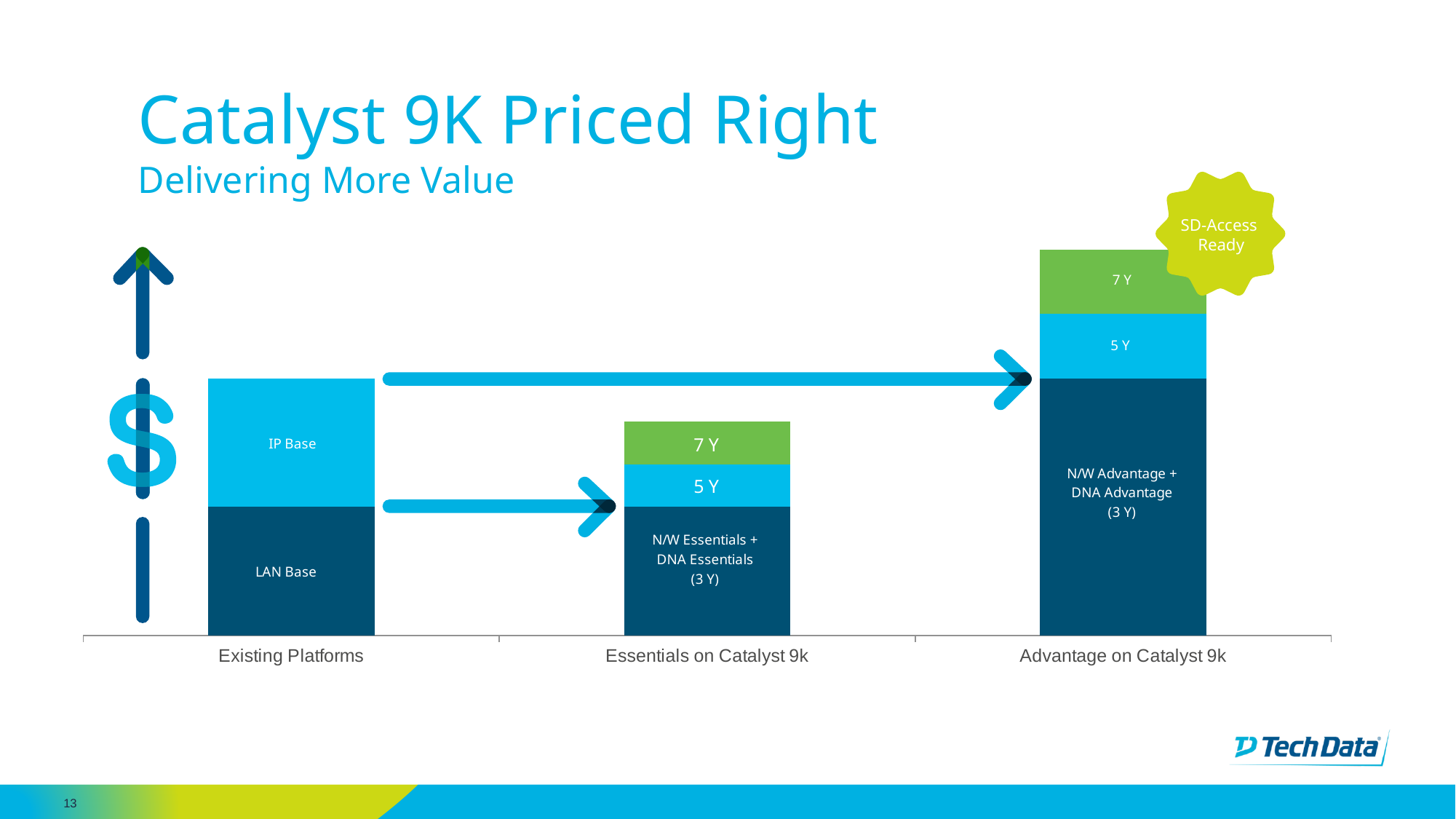
Which bar is taller, Existing Platforms or Essentials on Catalyst 9k? Existing Platforms What is the label on the bottom segment of the Essentials on Catalyst 9k bar? N/W Essentials + DNA Essentials (3 Y) How many segments make up the Advantage on Catalyst 9k bar? 3 What are the two segments labelled in the Existing Platforms bar? IP Base and LAN Base How many categories are shown along the x axis of the chart? 3 Which category has the tallest bar in the chart? Advantage on Catalyst 9k Which bar is taller, Advantage on Catalyst 9k or Existing Platforms? Advantage on Catalyst 9k Which category has the shortest bar in the chart? Essentials on Catalyst 9k What kind of chart is shown on the slide? Stacked bar chart What is the title of the slide containing the chart? Catalyst 9K Priced Right What is the label on the bottom segment of the Advantage on Catalyst 9k bar? N/W Advantage + DNA Advantage (3 Y) What does the badge next to the Advantage on Catalyst 9k bar say? SD-Access Ready